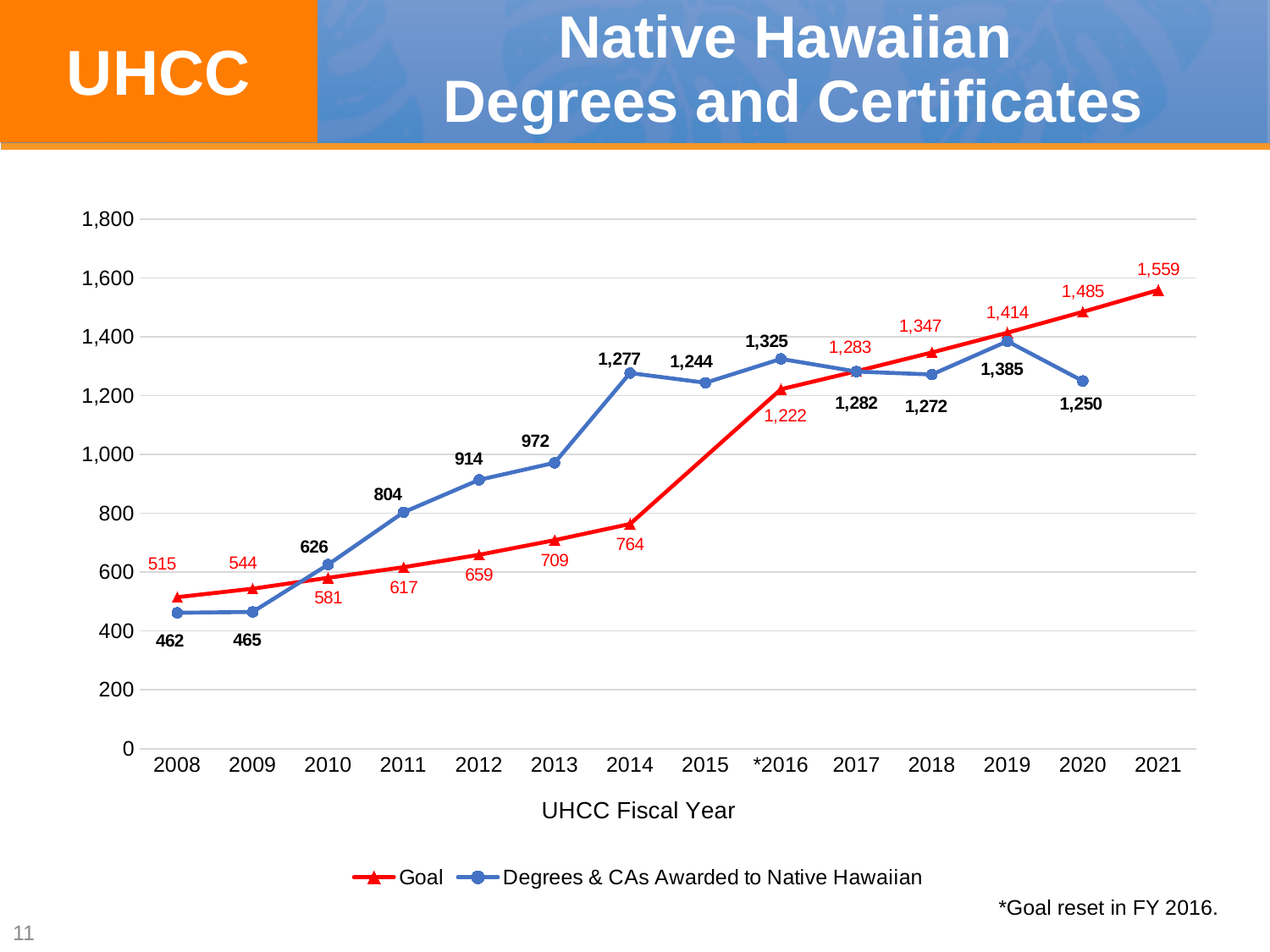
In which fiscal year is the Degrees & CAs Awarded to Native Hawaiian value highest? 2019 How many fiscal years are shown on the x axis? 14 What kind of chart is shown on the slide? Line chart Does the Goal series rise or fall from 2008 to 2021? Rise What is the value of Degrees & CAs Awarded to Native Hawaiian in 2014? 1,277 How many series does the legend list? 2 In which fiscal year is the Degrees & CAs Awarded to Native Hawaiian value lowest? 2008 In 2016, which is larger: the Goal or the Degrees & CAs Awarded to Native Hawaiian? Degrees & CAs Awarded to Native Hawaiian What is the Goal value for 2010? 581 What is the Goal value for 2021? 1,559 Is the Degrees & CAs Awarded to Native Hawaiian value for 2013 greater or less than 1,000? less What is the difference between the Goal and the Degrees & CAs Awarded to Native Hawaiian in 2020? 235